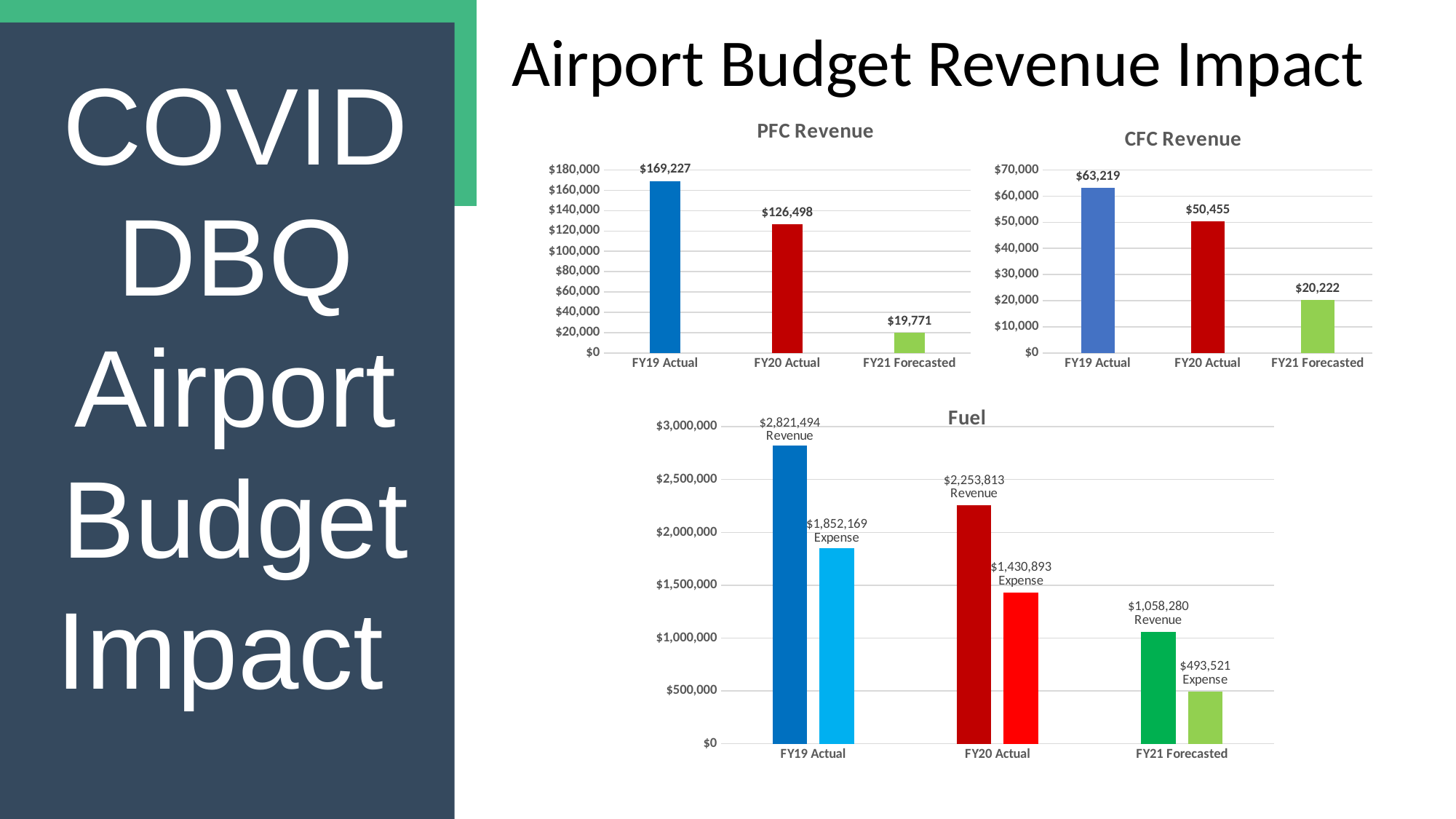
In the PFC Revenue chart, what is the value for FY19 Actual? $169,227 In the Fuel chart, what is the Revenue value for FY20 Actual? $2,253,813 In the CFC Revenue chart, which category has the highest value? FY19 Actual In the Fuel chart, what is the Expense value for FY21 Forecasted? $493,521 In the Fuel chart, which is larger for FY19 Actual, Revenue or Expense? Revenue In the PFC Revenue chart, which category has the lowest value? FY21 Forecasted In the PFC Revenue chart, what is the difference between FY19 Actual and FY20 Actual? $42,729 What kind of chart is the PFC Revenue chart? bar chart In the CFC Revenue chart, do the values rise or fall from FY19 Actual to FY21 Forecasted? fall In the CFC Revenue chart, what is the value for FY21 Forecasted? $20,222 In the Fuel chart, what is the difference between Revenue and Expense for FY20 Actual? $822,920 How many categories are shown on the x axis of the Fuel chart? 3